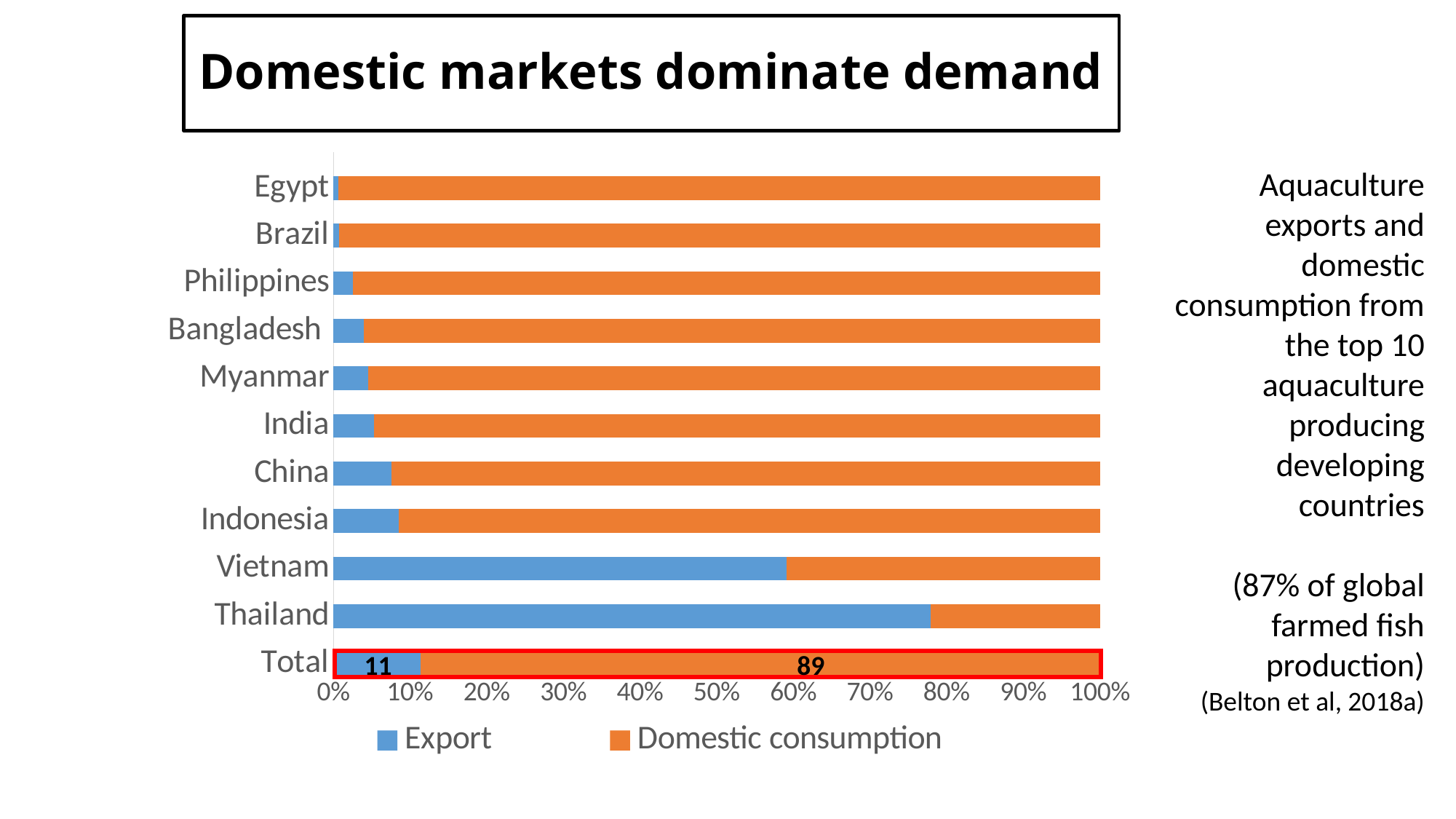
How many series does the legend list? 2 Which country has the highest Export share? Thailand Which has the larger Export share, Vietnam or Thailand? Thailand Is the Export share for Vietnam greater or less than 50%? greater What is the Export value shown for the Total bar? 11 What kind of chart is shown on the slide? Stacked bar chart What is the sum of the two labelled values on the Total bar? 100 What is the Domestic consumption value shown for the Total bar? 89 What are the two series named in the legend? Export and Domestic consumption Which has the larger Export share, Indonesia or Bangladesh? Indonesia Is the Export share for China greater or less than 10%? less How many categories (bars) are shown on the chart? 11